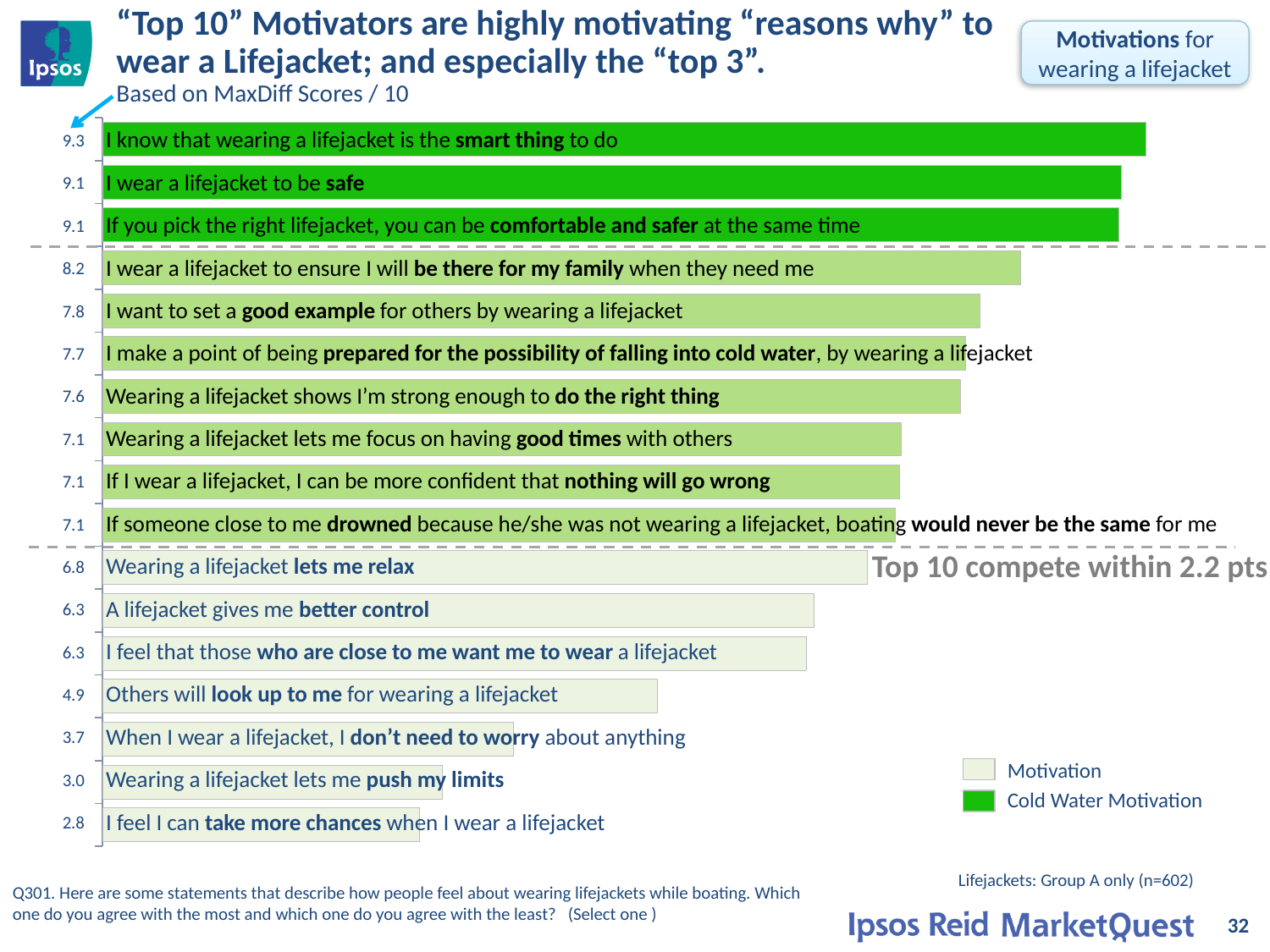
Which statement has the lowest MaxDiff score? I feel I can take more chances when I wear a lifejacket How many statements (bars) are shown in the chart? 17 According to the legend, what does the bright green colour represent? Cold Water Motivation How many entries does the legend list? 2 What is the MaxDiff score for "I know that wearing a lifejacket is the smart thing to do"? 9.3 What type of chart is shown on the slide? Bar chart What is the difference in MaxDiff score between "I wear a lifejacket to ensure I will be there for my family when they need me" and "Wearing a lifejacket lets me relax"? 1.4 Which has a higher MaxDiff score: "Wearing a lifejacket shows I'm strong enough to do the right thing" or "A lifejacket gives me better control"? Wearing a lifejacket shows I'm strong enough to do the right thing What is the MaxDiff score for "I want to set a good example for others by wearing a lifejacket"? 7.8 What is the difference between the highest score (9.3) and the lowest score (2.8)? 6.5 What is the MaxDiff score for "Others will look up to me for wearing a lifejacket"? 4.9 Which statement has the highest MaxDiff score? I know that wearing a lifejacket is the smart thing to do